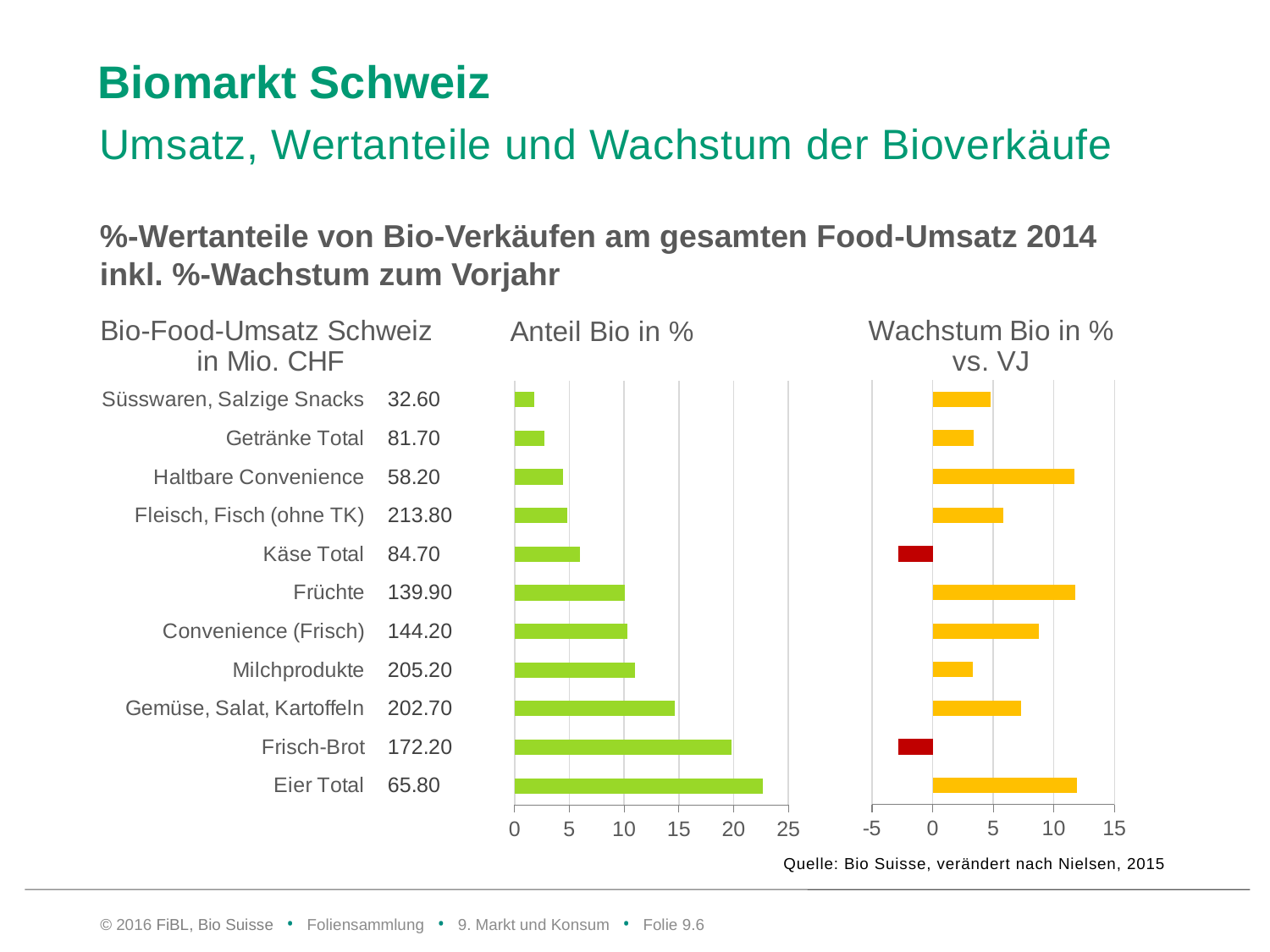
In the "Bio-Food-Umsatz Schweiz in Mio. CHF" column, what is the value for Fleisch, Fisch (ohne TK)? 213.80 In the "Wachstum Bio in % vs. VJ" chart, is the value for Convenience (Frisch) greater or less than 5? greater What kind of chart is the "Anteil Bio in %" chart? bar chart In the "Anteil Bio in %" chart, is the value for Käse Total greater or less than 5? greater In the "Bio-Food-Umsatz Schweiz in Mio. CHF" column, what is the difference between Milchprodukte and Gemüse, Salat, Kartoffeln? 2.50 In the "Wachstum Bio in % vs. VJ" chart, is the value for Getränke Total greater or less than 5? less In the "Anteil Bio in %" chart, which category has the highest value? Eier Total In the "Wachstum Bio in % vs. VJ" chart, which categories have negative growth? Käse Total and Frisch-Brot In the "Anteil Bio in %" chart, which category has the lowest value? Süsswaren, Salzige Snacks In the "Anteil Bio in %" chart, which is larger, Gemüse, Salat, Kartoffeln or Milchprodukte? Gemüse, Salat, Kartoffeln How many categories are shown in the "Anteil Bio in %" chart? 11